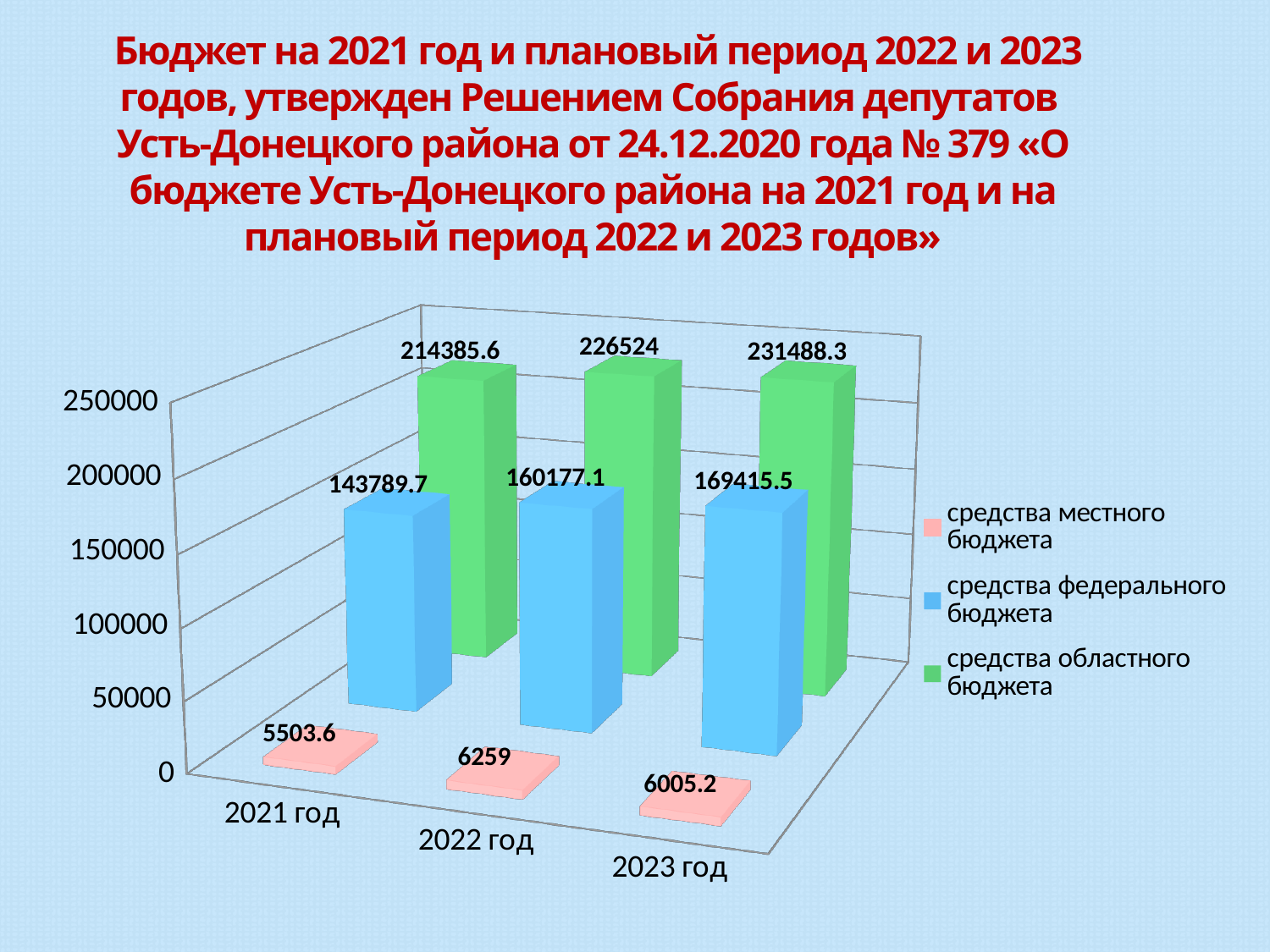
How many series does the legend list? 3 What is the difference between средства областного бюджета in 2022 год and 2021 год? 12138.4 Is the value for средства федерального бюджета in 2023 год greater or less than 150000? greater What is the value for средства областного бюджета in 2021 год? 214385.6 In which year is средства местного бюджета highest? 2022 год Which is larger: средства местного бюджета in 2022 год or in 2023 год? 2022 год What is the value for средства местного бюджета in 2023 год? 6005.2 What is the difference between средства федерального бюджета in 2023 год and 2021 год? 25625.8 In which year is средства федерального бюджета lowest? 2021 год What is the value for средства федерального бюджета in 2022 год? 160177.1 Do the values for средства областного бюджета rise or fall from 2021 год to 2023 год? rise What kind of chart is shown on the slide? bar chart